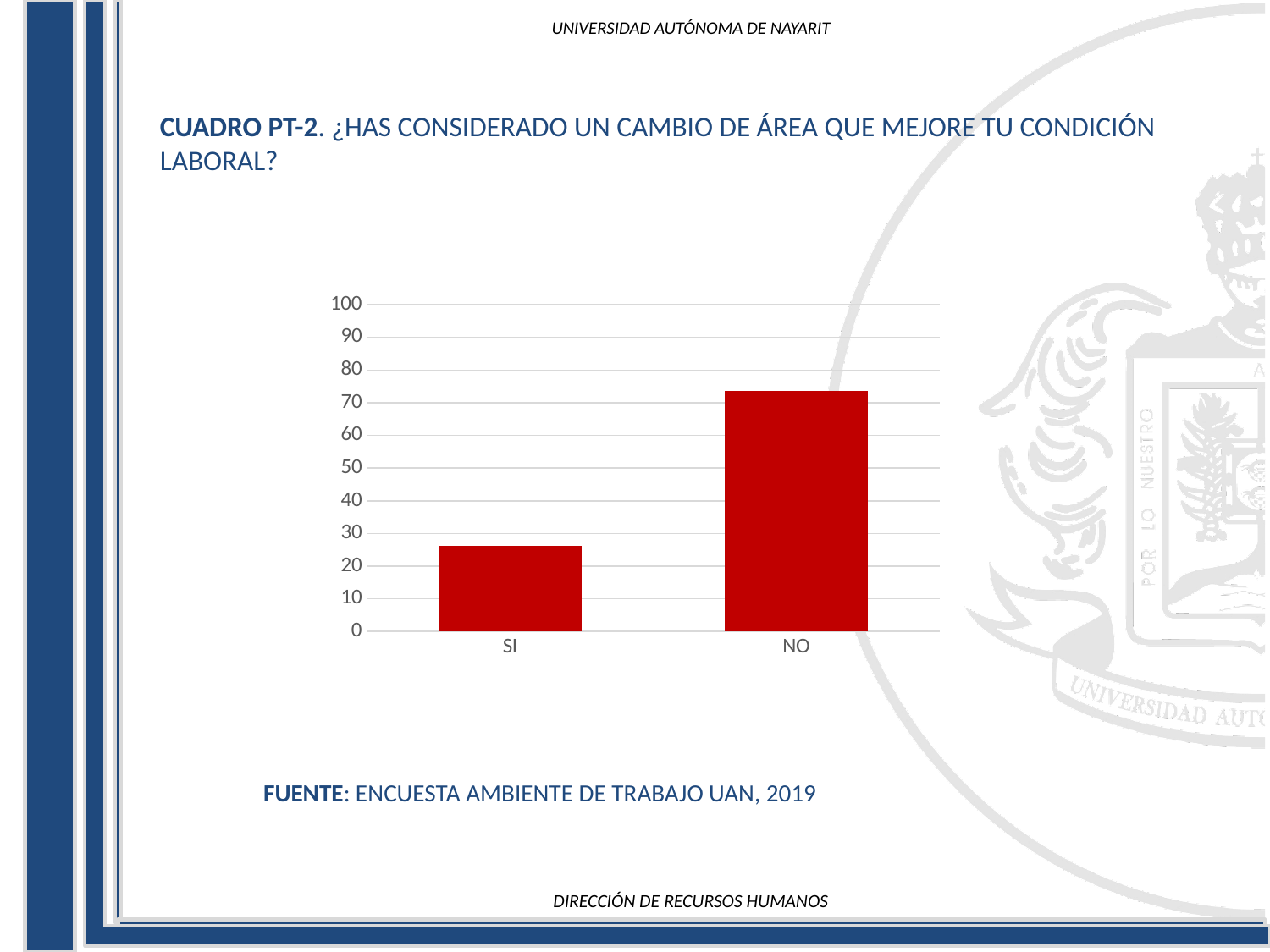
Is the value for SI greater or less than 30? less Is the value for SI greater or less than 20? greater Is the bar for NO larger or smaller than the bar for SI? larger What kind of chart is shown on the slide? bar chart How many categories are shown on the x axis of the chart? 2 Is the value for NO greater or less than 70? greater Which category has the highest bar, SI or NO? NO Which category has the lowest bar? SI What colour are the bars in the chart? red What is the maximum value shown on the y axis of the chart? 100